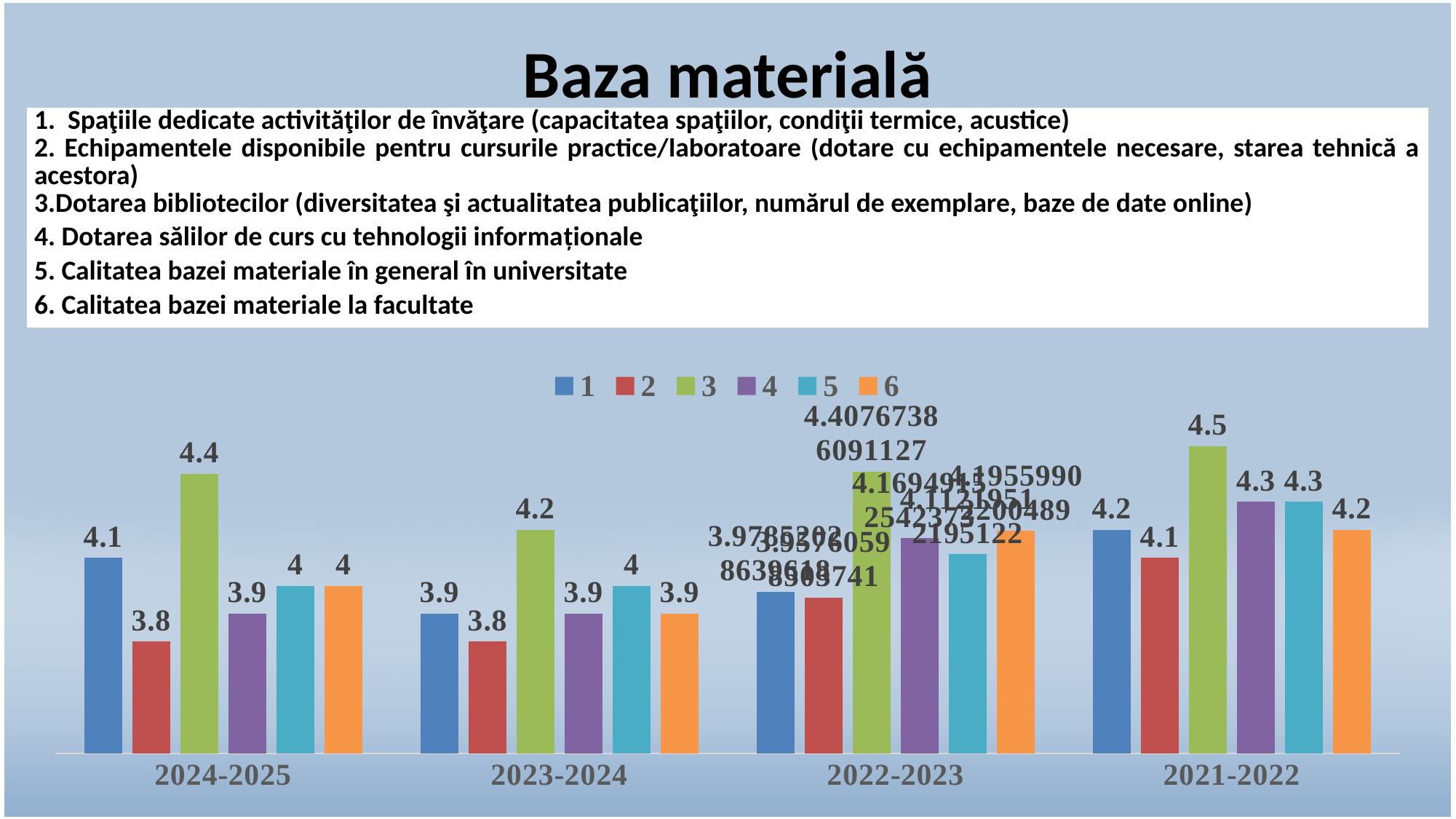
What is the value for series 1 in 2024-2025? 4.1 Which is larger in 2023-2024: series 3 or series 6? series 3 How many academic year categories are shown on the x axis? 4 How many series does the legend list? 6 What is the value for series 2 in 2023-2024? 3.8 Which series has the highest value in 2021-2022? 3 Which series has the lowest value in 2024-2025? 2 What kind of chart is shown on the slide? bar chart What is the value for series 3 in 2024-2025? 4.4 What is the difference between series 3 and series 1 in 2021-2022? 0.3 What is the value for series 4 in 2021-2022? 4.3 What is the difference between series 3 and series 2 in 2024-2025? 0.6